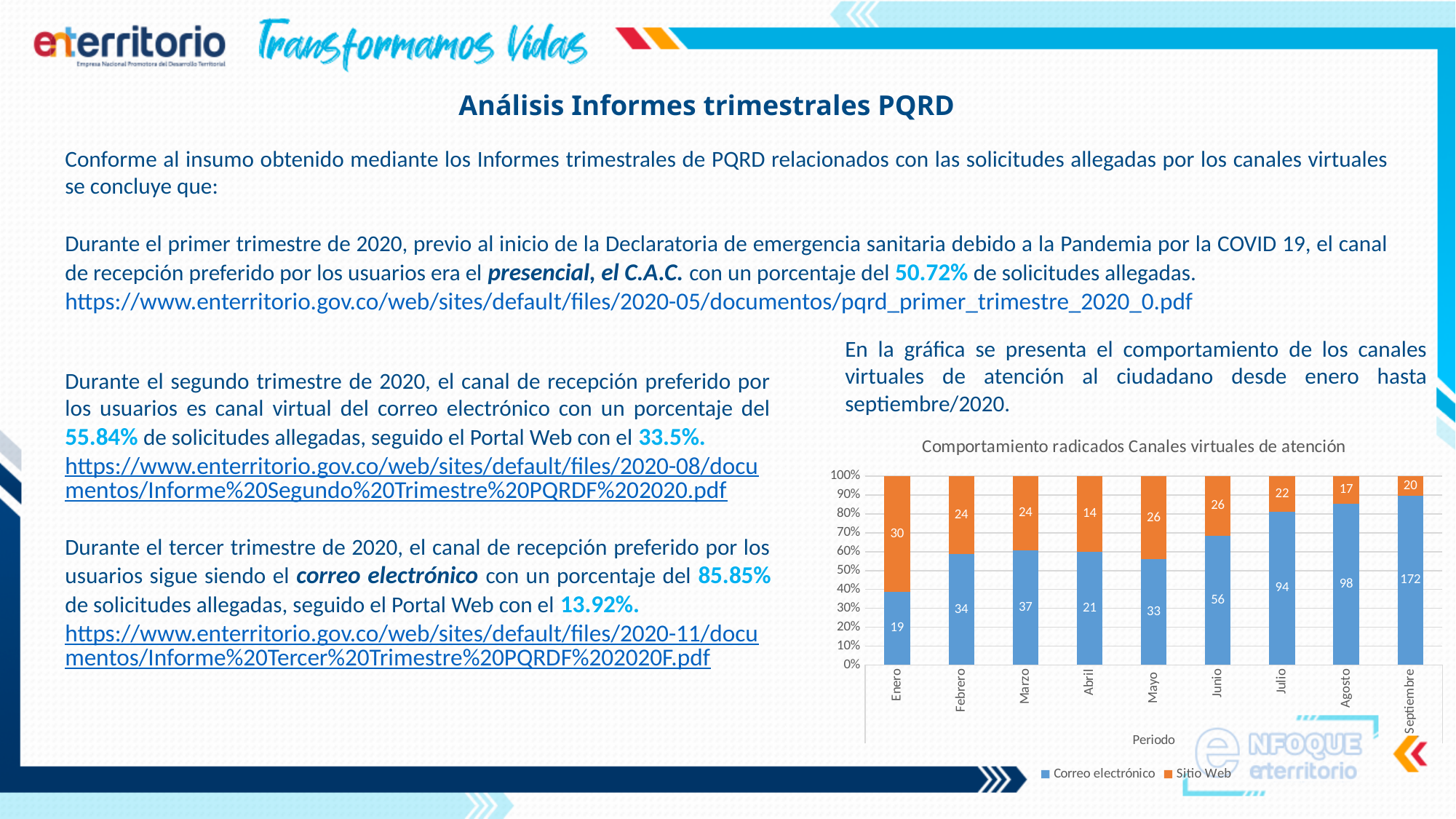
How many months are shown on the x axis? 9 What is the value for Correo electrónico in Abril? 21 What is the title of the chart? Comportamiento radicados Canales virtuales de atención Which month has the lowest value for Sitio Web? Abril How many series does the legend list? 2 Which is larger, the Sitio Web value for Mayo or the Sitio Web value for Julio? Mayo What is the total of the stacked bar for Junio? 82 What kind of chart is shown on the slide? Stacked bar chart What is the value for Sitio Web in Enero? 30 What is the difference between the Correo electrónico values for Agosto and Julio? 4 Which month has the highest value for Correo electrónico? Septiembre What is the value for Correo electrónico in Septiembre? 172